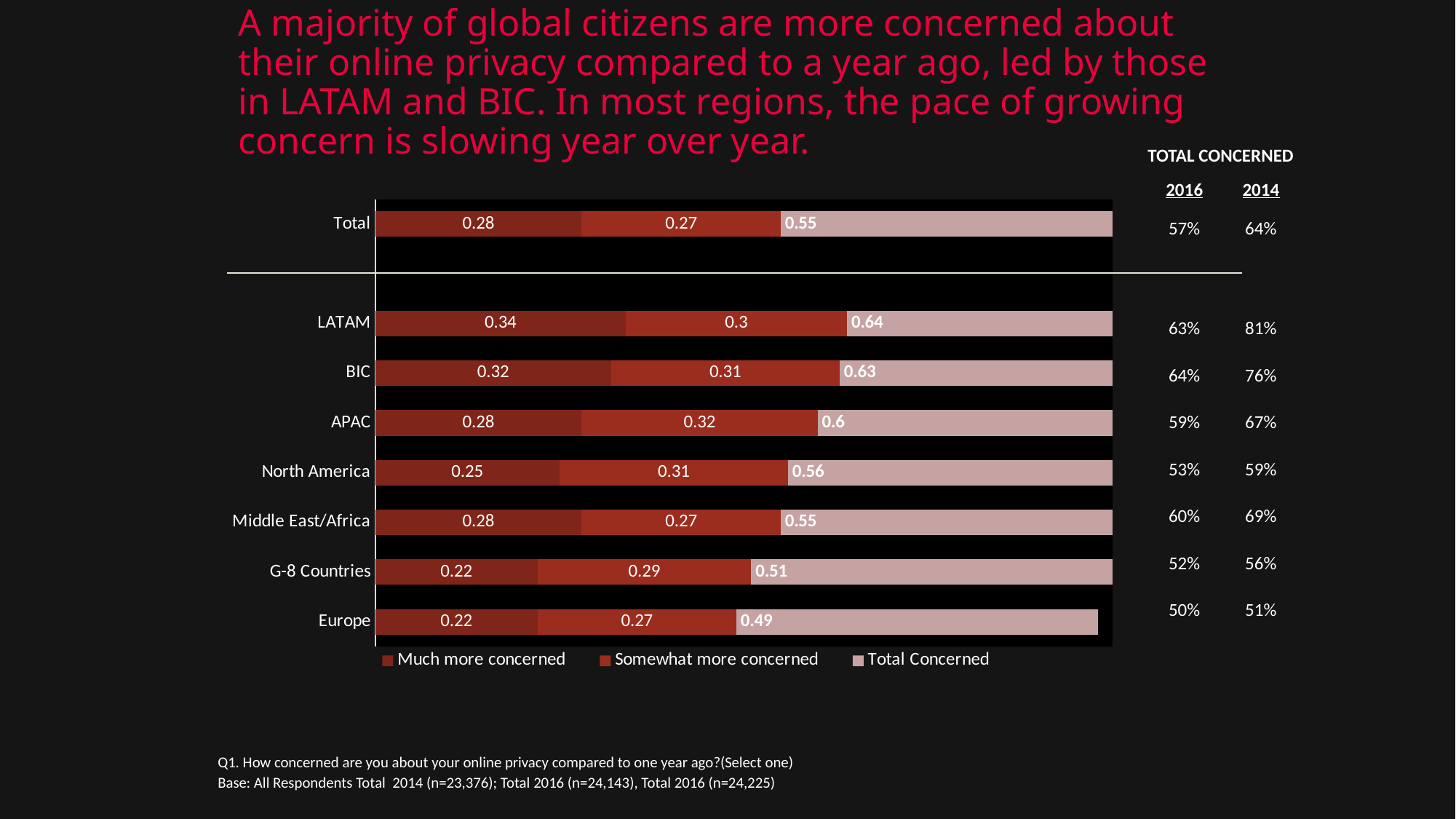
What is the difference between the 'Total Concerned' values for LATAM and Europe? 0.15 How many categories are shown on the chart? 8 What is the 'Total Concerned' value for Europe? 0.49 What is the 'Much more concerned' value for LATAM? 0.34 Which category has the lowest 'Total Concerned' value? Europe What kind of chart is shown on the slide? Stacked bar chart What is the difference between the 'Much more concerned' values for BIC and North America? 0.07 How many series does the legend list? 3 Which has a larger 'Somewhat more concerned' value, BIC or Middle East/Africa? BIC What is the 'Somewhat more concerned' value for APAC? 0.32 Which category has the highest 'Much more concerned' value? LATAM Which category has the highest 'Total Concerned' value? LATAM